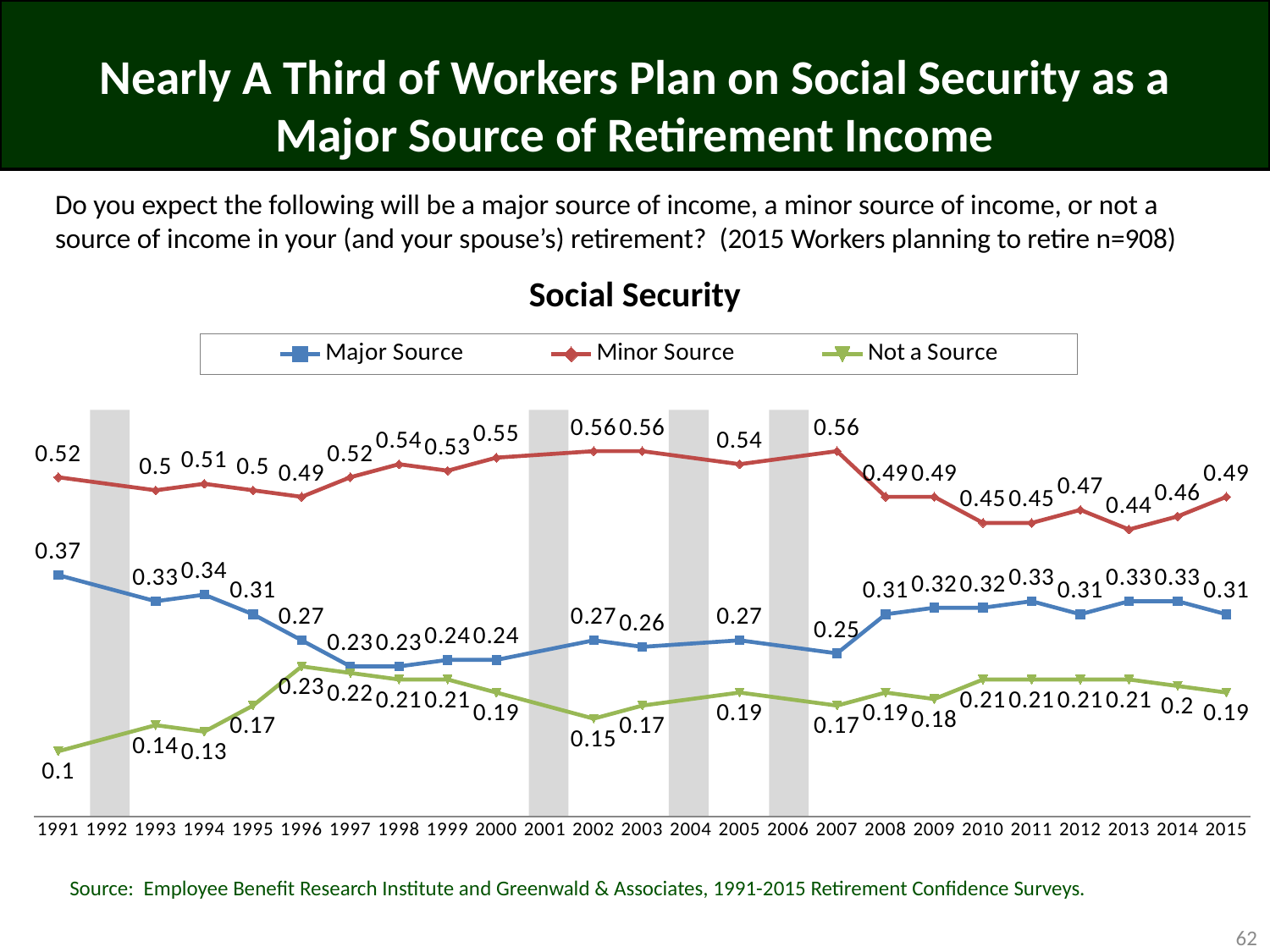
What is the value for Minor Source in 2013? 0.44 What is the title of the chart? Social Security What kind of chart is shown on the slide? Line chart Does the Major Source value rise or fall from 1991 to 1997? Fall What is the value for Not a Source in 1996? 0.23 Which is larger in 2013: the Major Source value or the Not a Source value? Major Source In which year is the Major Source value highest? 1991 What is the value for Major Source in 2015? 0.31 In which year is the Not a Source value lowest? 1991 How many series does the legend list? 3 What is the difference between the Minor Source and Major Source values in 1991? 0.15 What is the value for Minor Source in 2007? 0.56